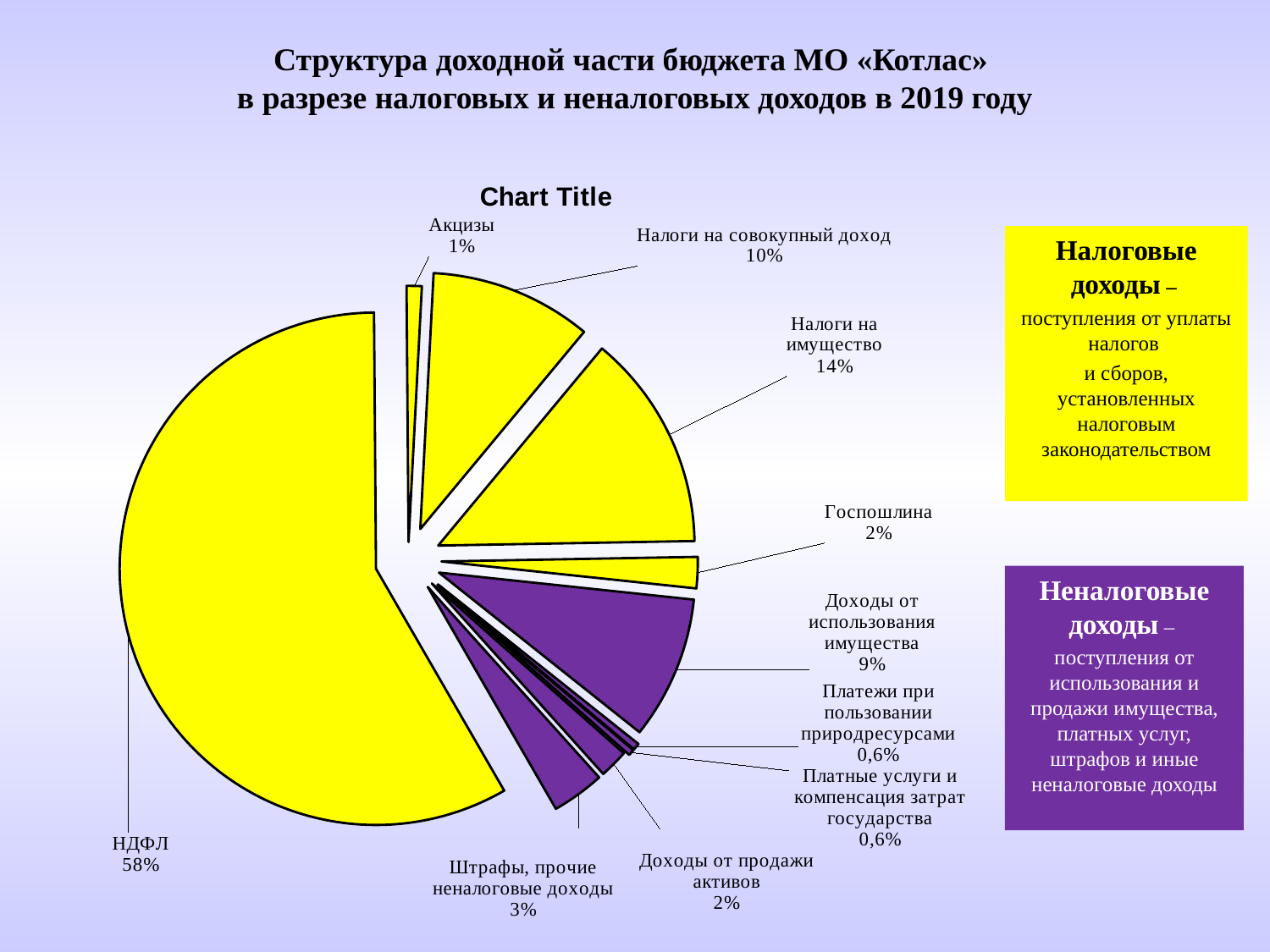
What is the value shown for Доходы от использования имущества? 9% What is the value shown for Налоги на имущество? 14% What share of the pie does НДФЛ account for? 58% How many slices does the pie chart have? 10 What is the title printed above the pie chart? Chart Title What is the value shown for Штрафы, прочие неналоговые доходы? 3% Which is larger, Налоги на совокупный доход or Налоги на имущество? Налоги на имущество What is the value shown for Платежи при пользовании природресурсами? 0,6% What is the difference between the shares of НДФЛ and Налоги на имущество? 44% What type of chart is shown on the slide? pie chart Which category has the largest slice of the pie? НДФЛ What colour are the slices representing non-tax revenues (неналоговые доходы)? purple